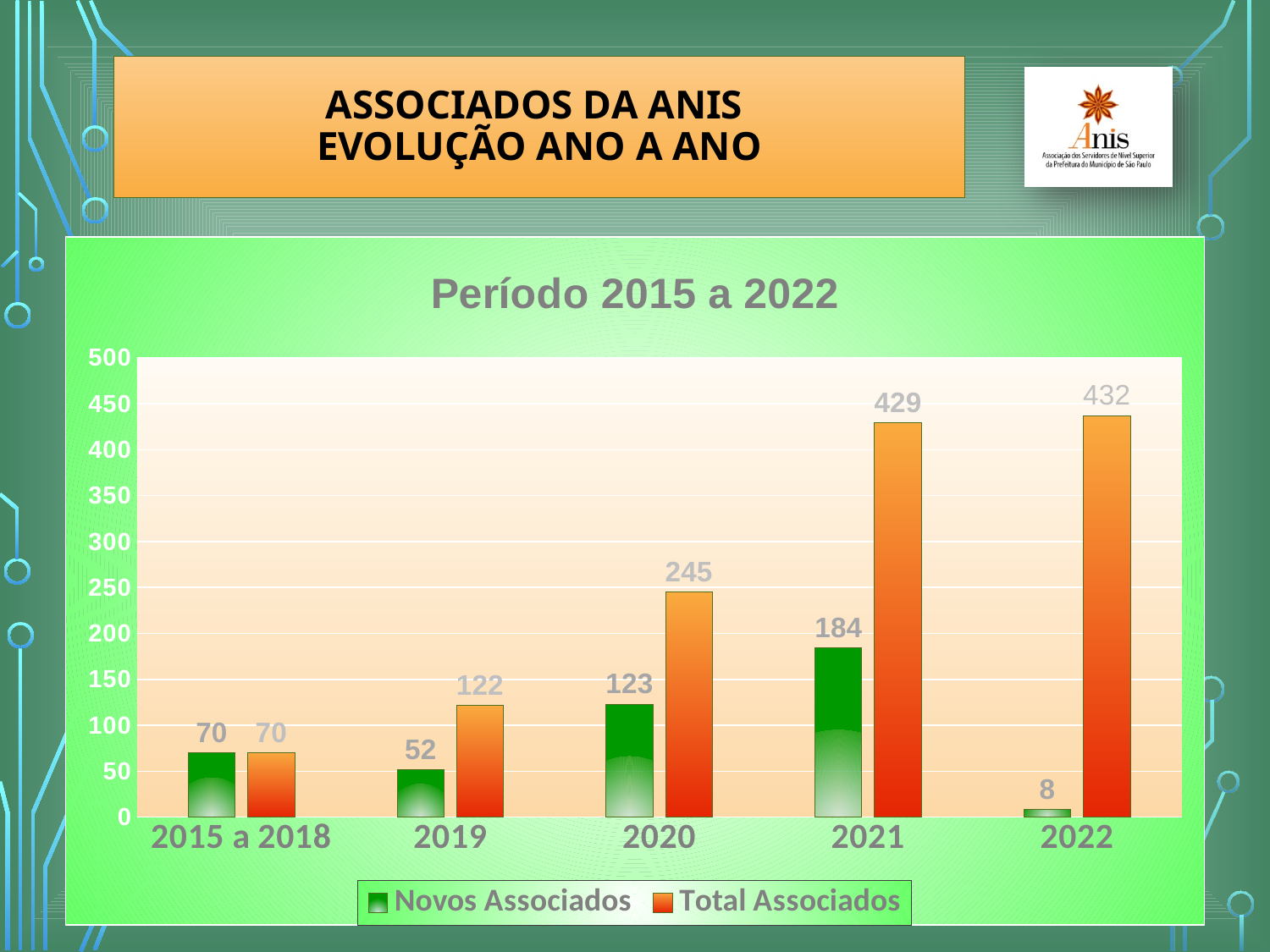
Which is larger: Novos Associados in 2020 or Novos Associados in 2019? Novos Associados in 2020 What is the value of Total Associados for 2020? 245 How many categories are shown on the x axis? 5 Which category has the lowest Novos Associados value? 2022 What is the value of Novos Associados for 2022? 8 How many series does the legend list? 2 What is the difference between Total Associados in 2021 and in 2020? 184 Which category has the highest Total Associados value? 2022 What is the title of the chart? Período 2015 a 2022 Is the Total Associados value for 2021 greater or less than 400? greater What kind of chart is shown on the slide? Bar chart What is the value of Novos Associados for 2021? 184